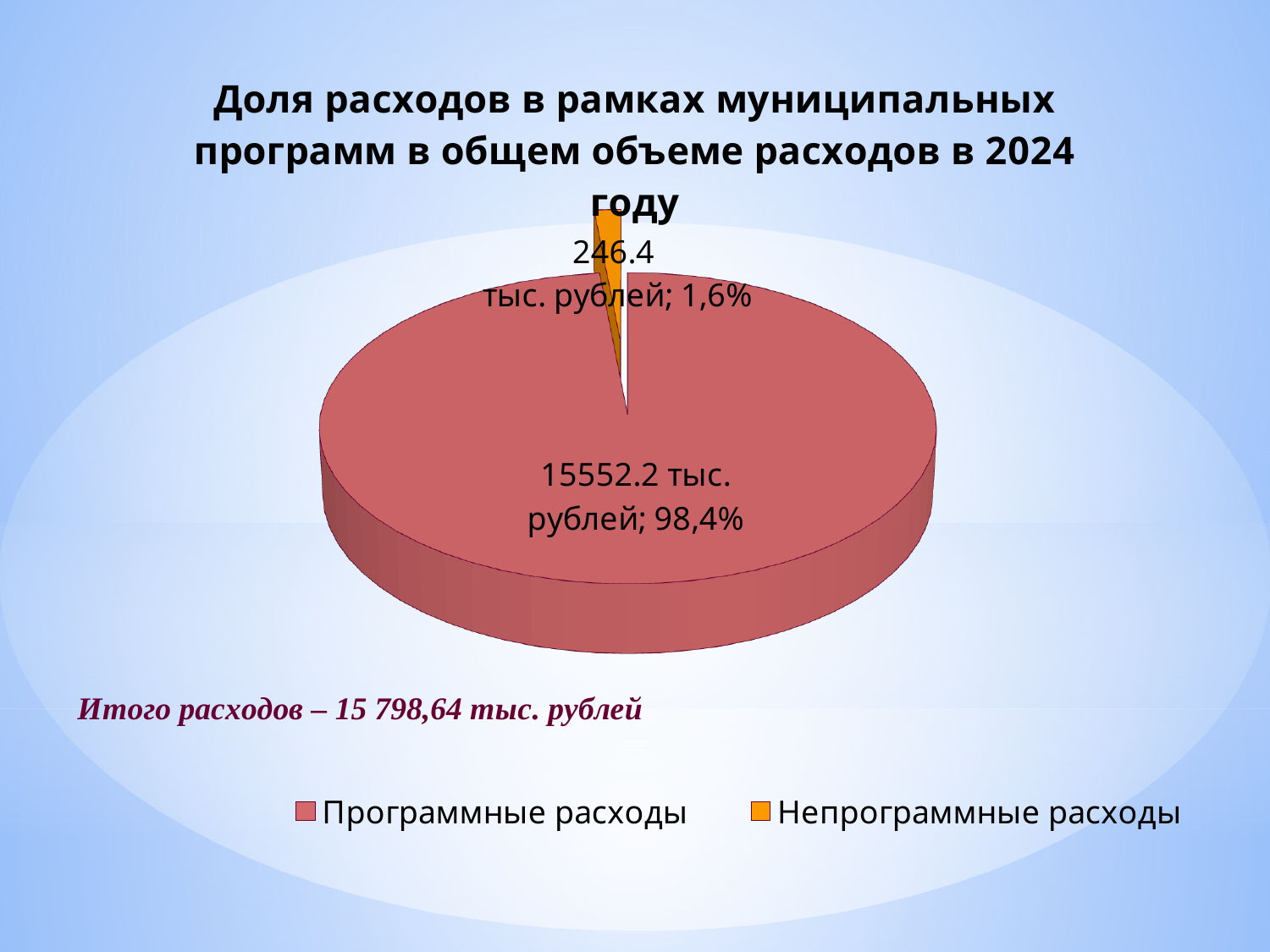
What colour is the slice for Непрограммные расходы? Orange What value is shown for Непрограммные расходы? 246.4 тыс. рублей What share of the pie does Программные расходы represent? 98,4% Which category has the largest slice of the pie? Программные расходы Which is larger, Программные расходы or Непрограммные расходы? Программные расходы What share of the pie does Непрограммные расходы represent? 1,6% What is the title of the chart? Доля расходов в рамках муниципальных программ в общем объеме расходов в 2024 году What value is shown for Программные расходы? 15552.2 тыс. рублей What kind of chart is shown on the slide? Pie chart How many slices does the pie chart have? 2 How many entries does the legend list? 2 Which category has the smallest slice of the pie? Непрограммные расходы